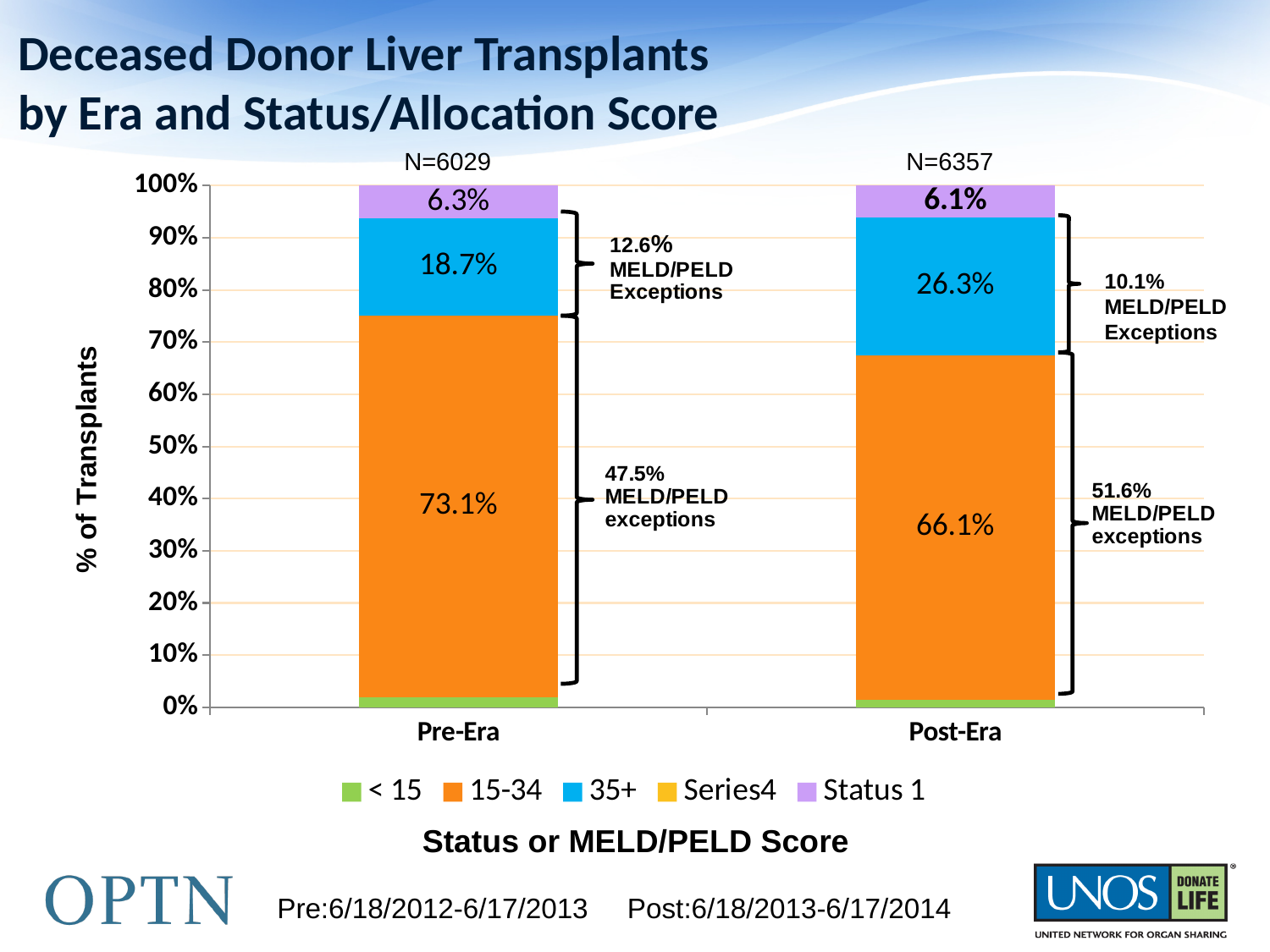
What percentage of Pre-Era transplants were in the 15-34 MELD/PELD score group? 73.1% How many eras (categories) are shown on the x axis? 2 What kind of chart is shown on the slide? Stacked bar chart What percentage of Pre-Era transplants were Status 1? 6.3% What is the difference between the 15-34 share in the Pre-Era and the Post-Era? 7.0% Which era has the larger share of transplants in the 35+ group? Post-Era What percentage of Post-Era transplants were in the 35+ MELD/PELD score group? 26.3% Which segment is the largest in the Post-Era bar? 15-34 How many series does the legend list? 5 Is the 15-34 share in the Post-Era greater or less than 70%? less What is the N shown above the Post-Era bar? N=6357 What percentage of Post-Era transplants were Status 1? 6.1%